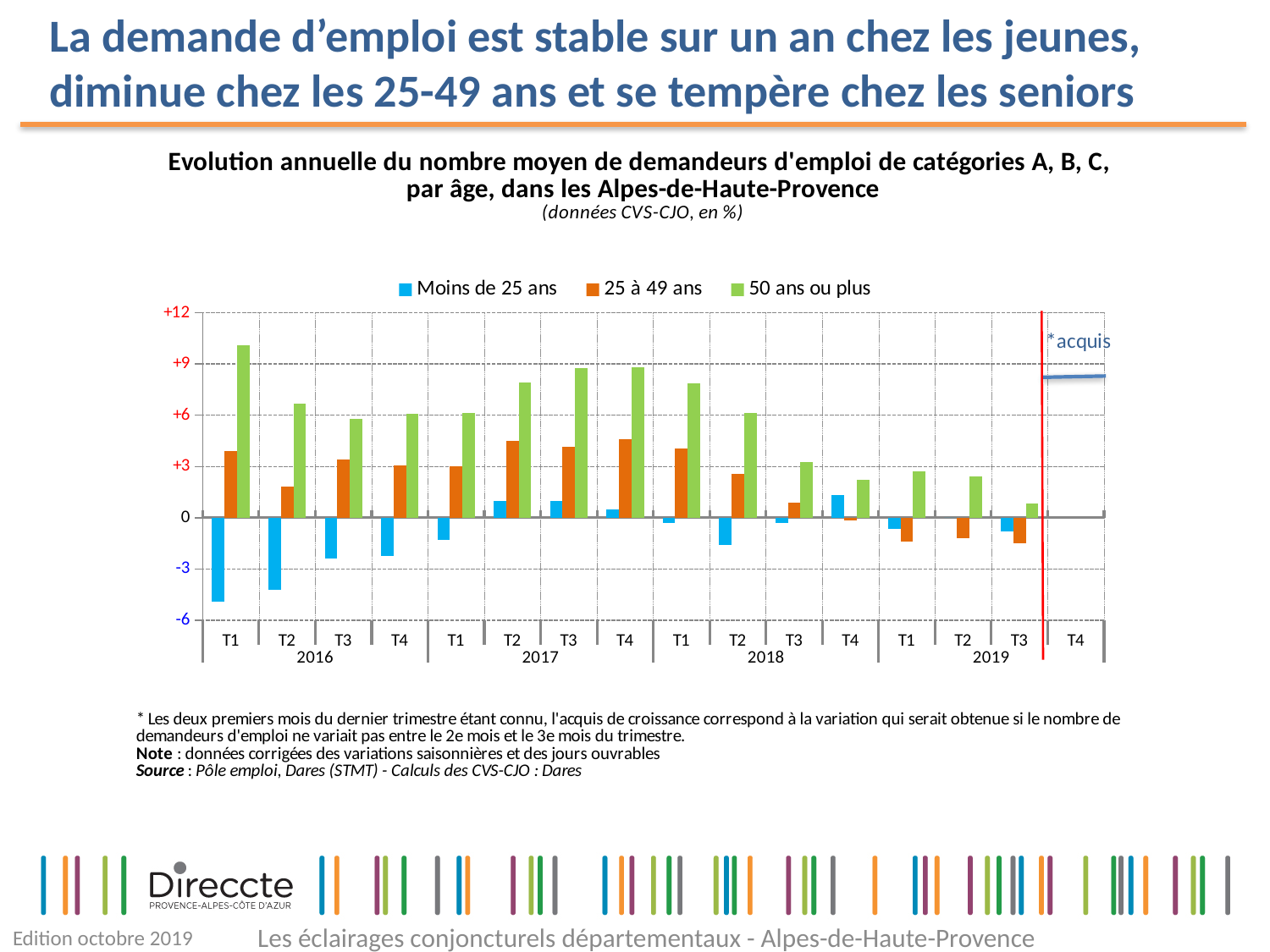
Is the value for '50 ans ou plus' in T1 2016 greater or less than +9? greater How many series does the legend list? 3 How many quarters are labelled along the x axis? 16 What kind of chart is shown on the slide? bar chart Which series are listed in the legend? Moins de 25 ans, 25 à 49 ans, 50 ans ou plus In T1 2016, which is larger: the value for '50 ans ou plus' or the value for '25 à 49 ans'? 50 ans ou plus Is the value for '50 ans ou plus' in T3 2019 greater or less than +3? less In which quarter does the 'Moins de 25 ans' series reach its lowest value? T1 2016 Is the value for '25 à 49 ans' in T1 2016 greater or less than +3? greater In which quarter does the '50 ans ou plus' series reach its highest value? T1 2016 Do the values for '50 ans ou plus' rise or fall from T1 2018 to T3 2019? fall